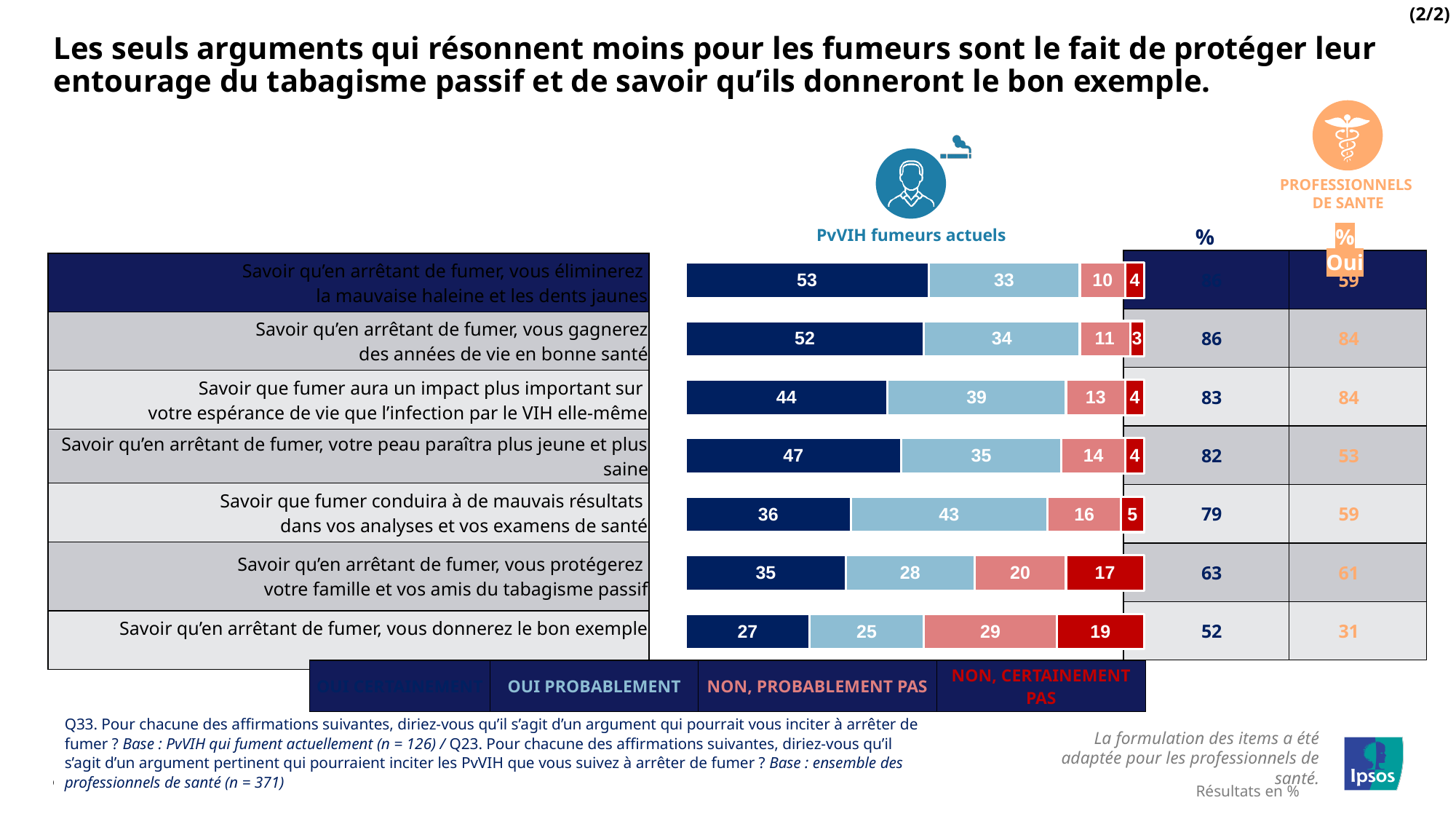
In the 'PvVIH fumeurs actuels' chart, what is the 'Non, certainement pas' value for 'Savoir qu'en arrêtant de fumer, vous donnerez le bon exemple'? 19 In the 'PvVIH fumeurs actuels' chart, what is the total of the segments for 'Savoir qu'en arrêtant de fumer, vous protégerez votre famille et vos amis du tabagisme passif'? 100 How many response categories (series) does the legend of the 'PvVIH fumeurs actuels' chart list? 4 In the 'PvVIH fumeurs actuels' chart, which statement has the highest first-segment (dark blue) value? Savoir qu'en arrêtant de fumer, vous éliminerez la mauvaise haleine et les dents jaunes What kind of chart is the 'PvVIH fumeurs actuels' chart? Stacked bar chart In the 'PvVIH fumeurs actuels' chart, which statement has the lowest first-segment (dark blue) value? Savoir qu'en arrêtant de fumer, vous donnerez le bon exemple In the '% Oui' column for PvVIH fumeurs actuels, what is the value for 'Savoir qu'en arrêtant de fumer, vous protégerez votre famille et vos amis du tabagisme passif'? 63 How many statements (bars) are shown in the 'PvVIH fumeurs actuels' chart? 7 In the 'PvVIH fumeurs actuels' chart, which has the larger 'Oui probablement' value: 'Savoir que fumer conduira à de mauvais résultats dans vos analyses et vos examens de santé' or 'Savoir qu'en arrêtant de fumer, votre peau paraîtra plus jeune et plus saine'? Savoir que fumer conduira à de mauvais résultats dans vos analyses et vos examens de santé In the 'PvVIH fumeurs actuels' chart, which statement has the highest 'Non, probablement pas' value? Savoir qu'en arrêtant de fumer, vous donnerez le bon exemple In the 'PvVIH fumeurs actuels' chart, what is the 'Oui probablement' value for 'Savoir qu'en arrêtant de fumer, vous gagnerez des années de vie en bonne santé'? 34 In the 'PvVIH fumeurs actuels' chart, what is the difference between the first-segment (dark blue) values for 'vous gagnerez des années de vie en bonne santé' and 'vous donnerez le bon exemple'? 25